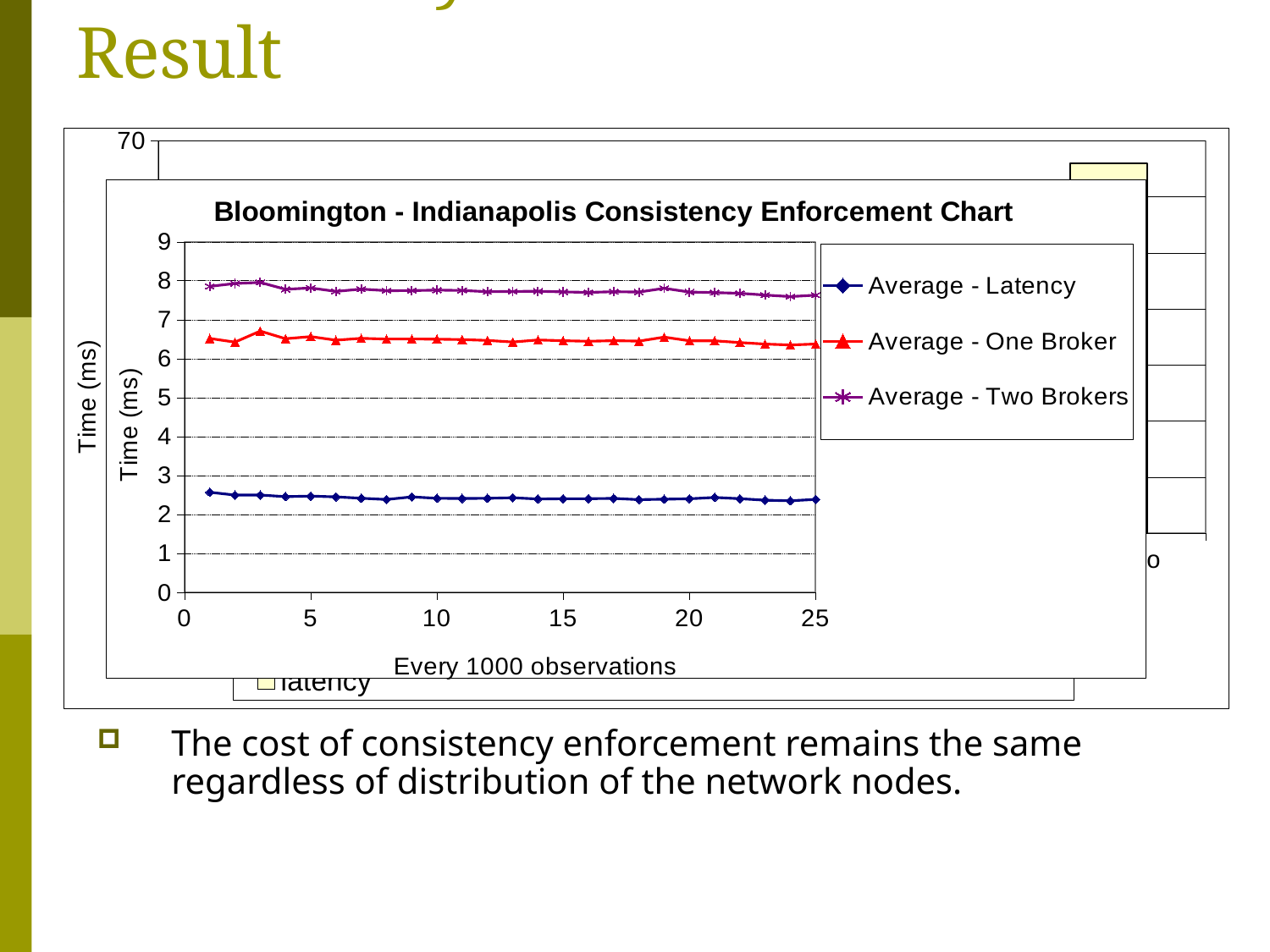
What is the y-axis label of the Bloomington - Indianapolis Consistency Enforcement Chart? Time (ms) What kind of chart is the Bloomington - Indianapolis Consistency Enforcement Chart? line chart In the Bloomington - Indianapolis Consistency Enforcement Chart, at x = 20, which is larger: Average - One Broker or Average - Latency? Average - One Broker How many series does the legend of the Bloomington - Indianapolis Consistency Enforcement Chart list? 3 In the Bloomington - Indianapolis Consistency Enforcement Chart, is the value for Average - Two Brokers at x = 5 greater or less than 7? greater In the Bloomington - Indianapolis Consistency Enforcement Chart, which series has the highest values? Average - Two Brokers In the Bloomington - Indianapolis Consistency Enforcement Chart, which series has the lowest values? Average - Latency In the Bloomington - Indianapolis Consistency Enforcement Chart, is the value for Average - Latency at x = 10 greater or less than 3? less In the Bloomington - Indianapolis Consistency Enforcement Chart, do the Average - Latency values rise, fall, or stay roughly flat along the x axis? stay roughly flat In the Bloomington - Indianapolis Consistency Enforcement Chart, is the value for Average - One Broker at x = 1 greater or less than 7? less What is the x-axis label of the Bloomington - Indianapolis Consistency Enforcement Chart? Every 1000 observations